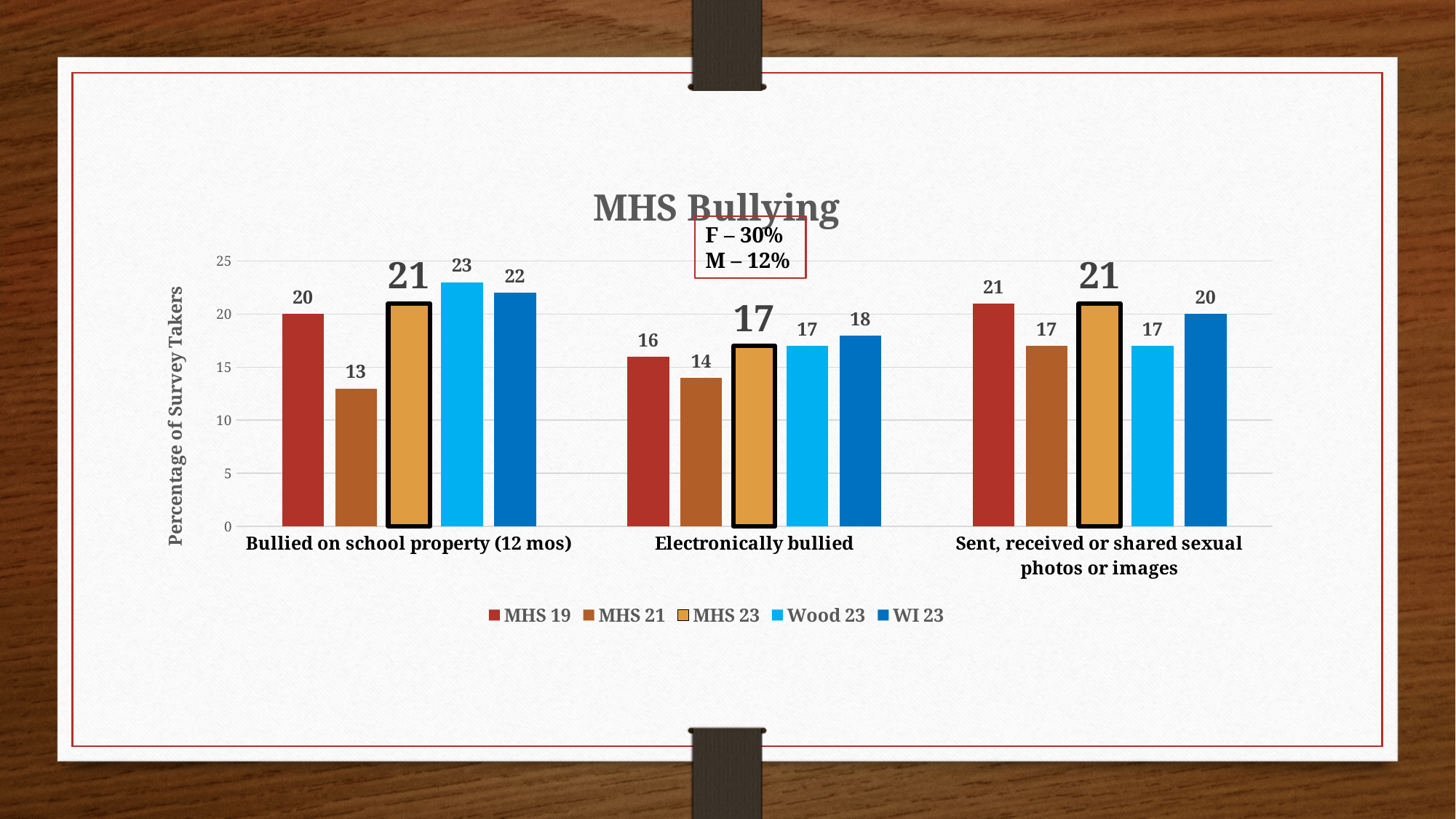
What is the value for MHS 23 in the 'Bullied on school property (12 mos)' category? 21 What is the label of the vertical axis? Percentage of Survey Takers How many categories are shown on the x axis? 3 What is the difference between the MHS 19 and MHS 21 values in the 'Bullied on school property (12 mos)' category? 7 Which series has the lowest value in the 'Electronically bullied' category? MHS 21 What kind of chart is shown on the slide? Bar chart How many series does the legend list? 5 What is the title of the chart? MHS Bullying Which series has the highest value in the 'Bullied on school property (12 mos)' category? Wood 23 What is the value for WI 23 in the 'Sent, received or shared sexual photos or images' category? 20 In the 'Sent, received or shared sexual photos or images' category, which is larger: MHS 23 or Wood 23? MHS 23 What is the value for MHS 21 in the 'Electronically bullied' category? 14